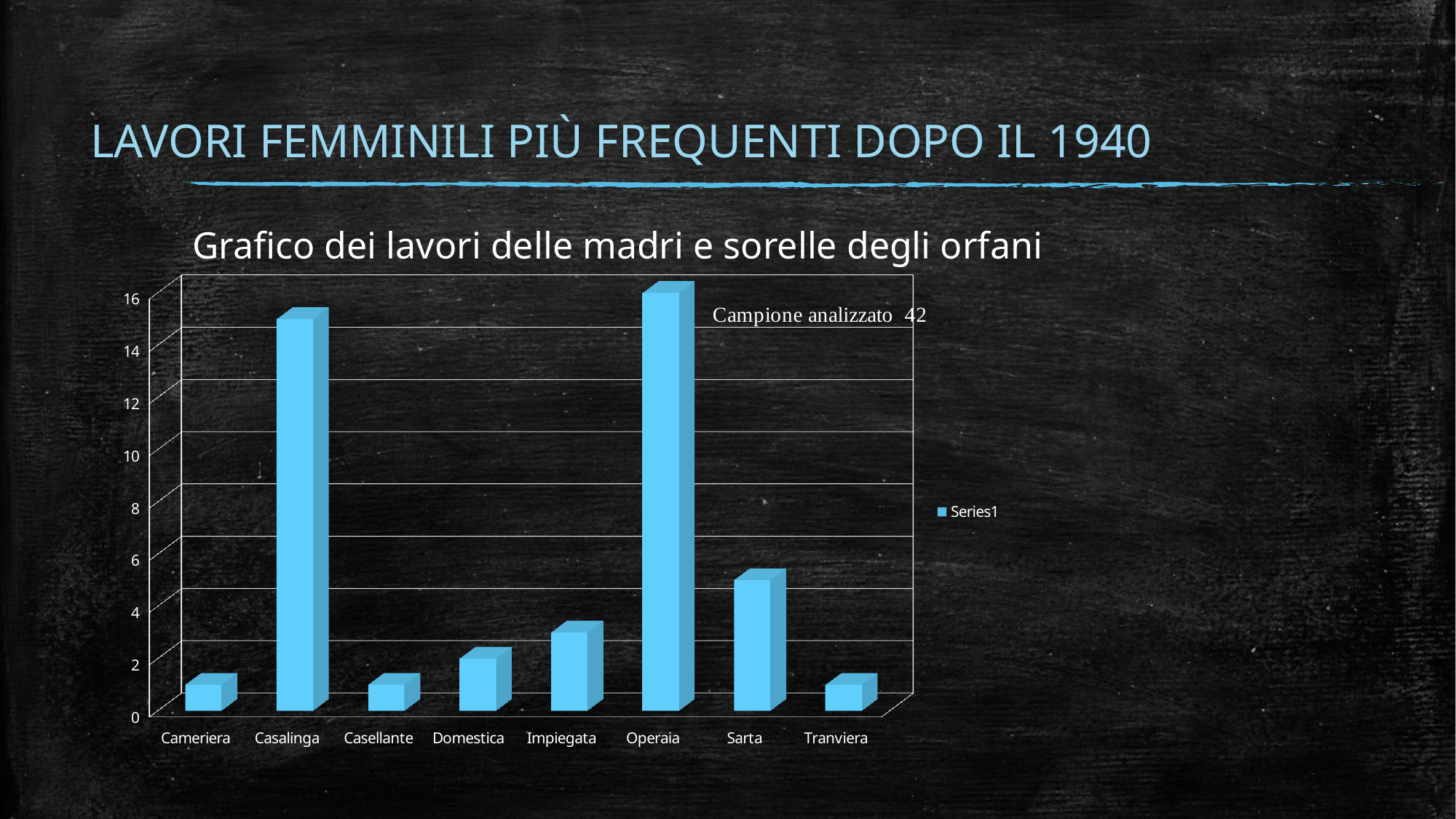
How many series does the chart legend list? 1 What kind of chart is shown on the slide? bar chart Which job category has the highest bar in the chart? Operaia What is the title of the chart? Grafico dei lavori delle madri e sorelle degli orfani How many job categories are shown on the x axis of the chart? 8 Is the value for Operaia greater or less than 14? greater Which is larger, the value for Impiegata or the value for Domestica? Impiegata Is the value for Impiegata greater or less than 4? less Is the value for Sarta greater or less than 8? less What sample size (Campione analizzato) is noted on the chart? 42 Which is larger, the value for Casalinga or the value for Sarta? Casalinga